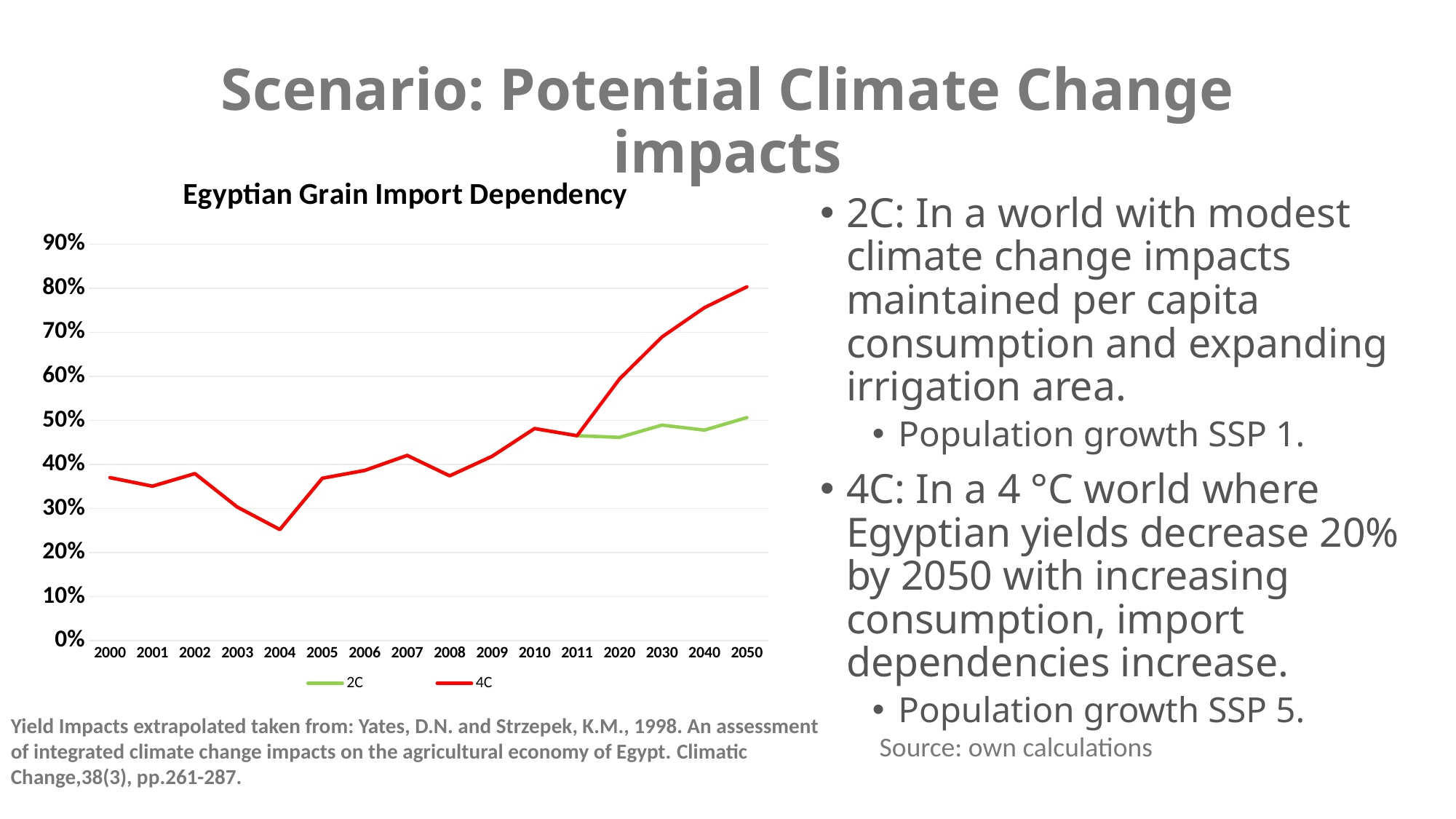
Is the value for 4C in 2004 greater or less than 30%? less Does the 4C series rise or fall between 2011 and 2050? rise In which year does the 4C series reach its highest value? 2050 Which colour is used for the 4C series? red What kind of chart is shown on the slide? line chart How many series does the chart legend list? 2 What is the title of the chart? Egyptian Grain Import Dependency Is the value for 4C in 2040 greater or less than 70%? greater In 2050, which series has the larger value, 2C or 4C? 4C How many years are shown on the x axis of the chart? 16 Is the value for 2C in 2020 greater or less than 50%? less In which year does the 4C series reach its lowest value? 2004